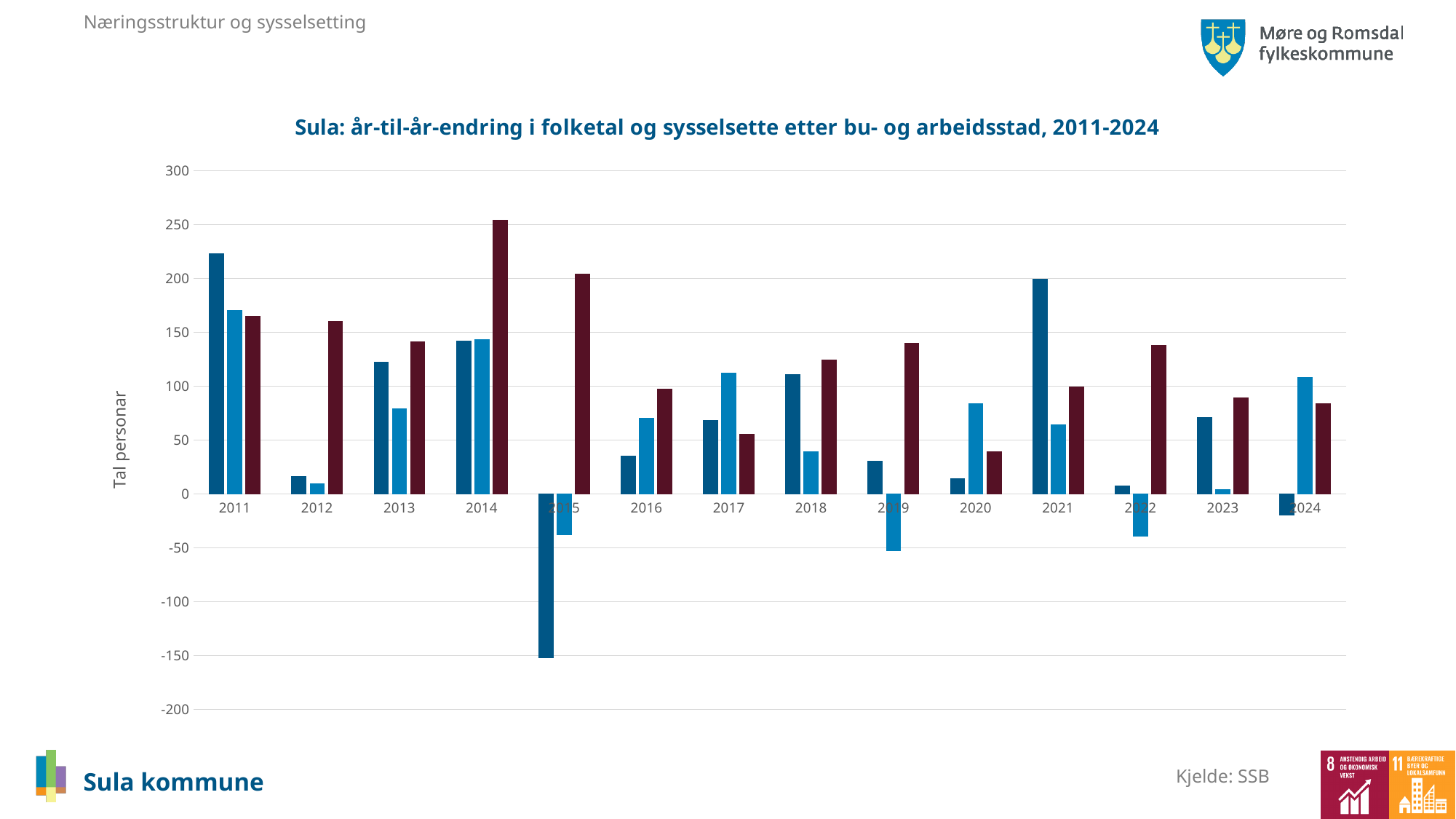
What type of chart is shown on the slide? Bar chart What is the label on the vertical axis of the chart? Tal personar In which year does the chart show the lowest (most negative) bar? 2015 Which is larger: the dark blue bar for 2011 or the dark blue bar for 2013? 2011 Is the value of the dark blue bar for 2021 greater or less than 150? greater Is the value of the light blue bar for 2020 greater or less than 50? greater Is the value of the dark blue bar for 2015 greater or less than -100? less How many years are shown along the x axis of the chart? 14 In which year does the chart show the tallest bar overall? 2014 What is the title of the chart? Sula: år-til-år-endring i folketal og sysselsette etter bu- og arbeidsstad, 2011-2024